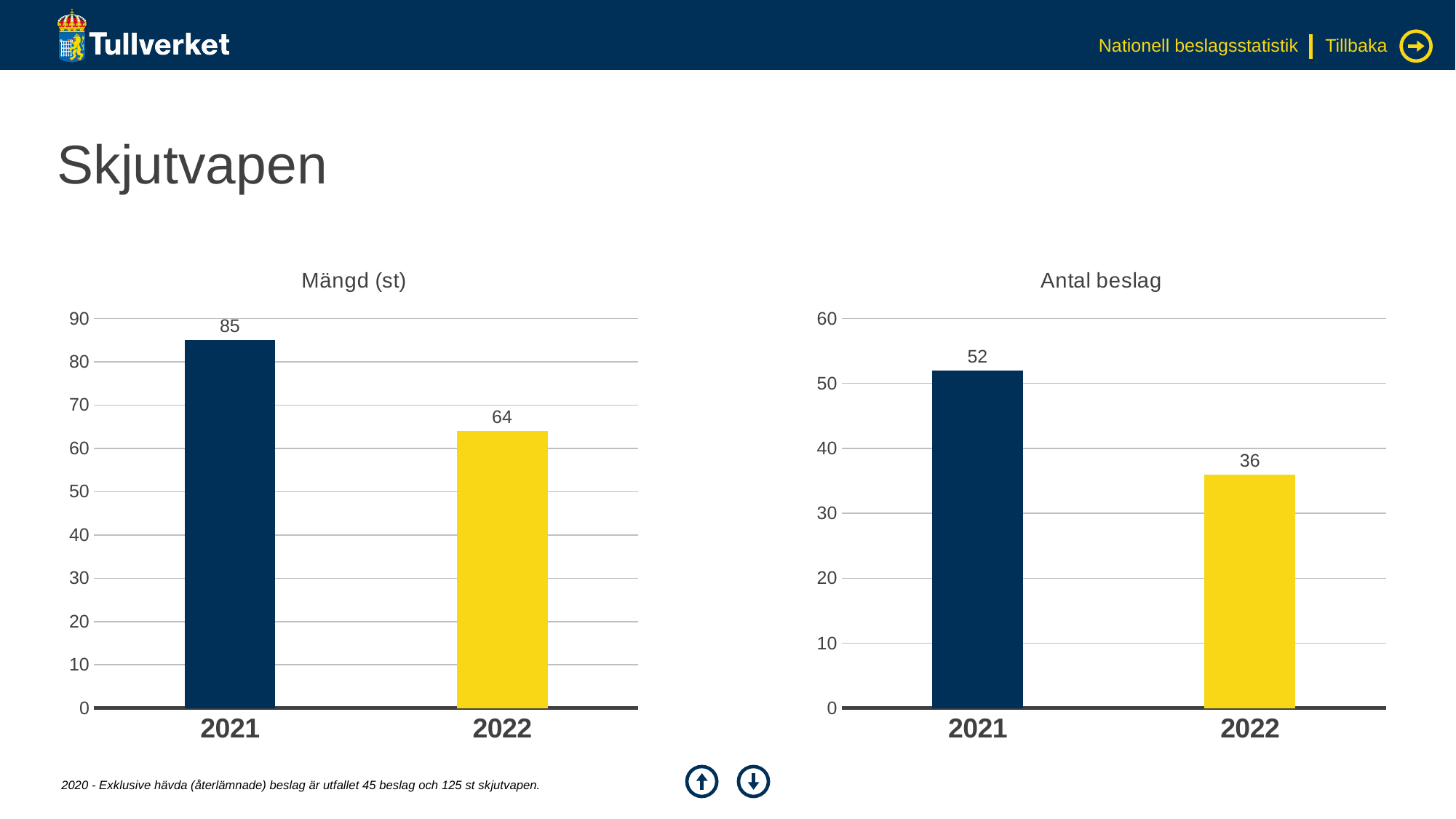
How many categories are shown in the 'Antal beslag' chart? 2 In the 'Mängd (st)' chart, what is the difference between the 2021 and 2022 values? 21 In the 'Mängd (st)' chart, what is the value for 2022? 64 In the 'Mängd (st)' chart, what is the value for 2021? 85 What kind of chart is the 'Mängd (st)' chart? bar chart In the 'Antal beslag' chart, what is the difference between the 2021 and 2022 values? 16 In the 'Antal beslag' chart, which is larger, the value for 2021 or 2022? 2021 In the 'Antal beslag' chart, what is the value for 2021? 52 In the 'Mängd (st)' chart, which year has the highest value? 2021 In the 'Antal beslag' chart, what is the value for 2022? 36 In the 'Mängd (st)' chart, do the values rise or fall from 2021 to 2022? fall In the 'Antal beslag' chart, which year has the lowest value? 2022